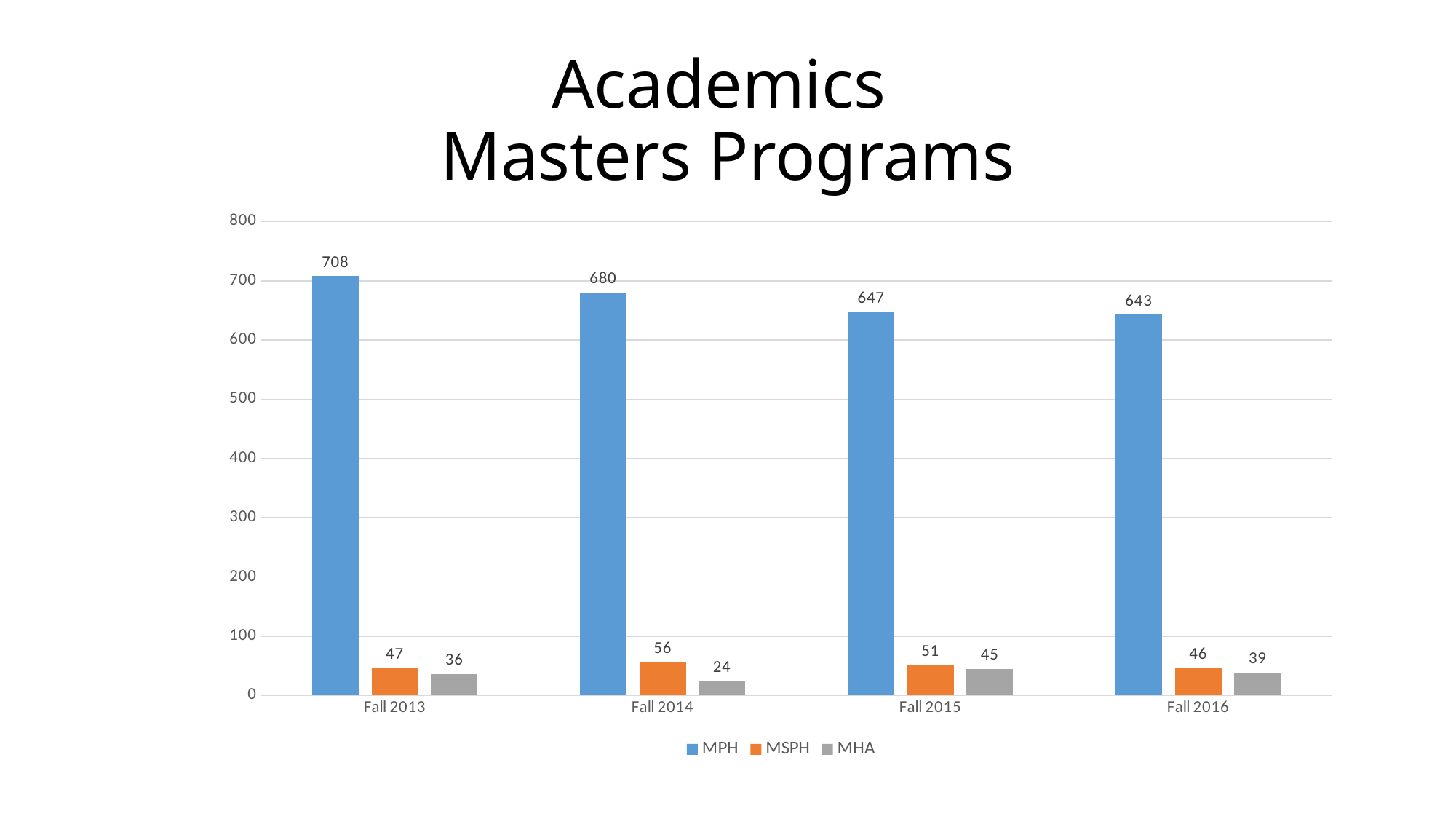
What is the MPH value for Fall 2013? 708 In which term is the MPH value highest? Fall 2013 What kind of chart is shown on the slide? bar chart Is the MPH value for Fall 2015 greater or less than 600? greater In which term is the MHA value lowest? Fall 2014 What is the MSPH value for Fall 2014? 56 What is the difference between the MPH values for Fall 2013 and Fall 2016? 65 Does the MPH value rise or fall from Fall 2013 to Fall 2016? fall How many terms are shown on the x axis? 4 How many series does the legend list? 3 What is the MHA value for Fall 2016? 39 Which is larger, the MSPH value for Fall 2015 or the MHA value for Fall 2015? MSPH